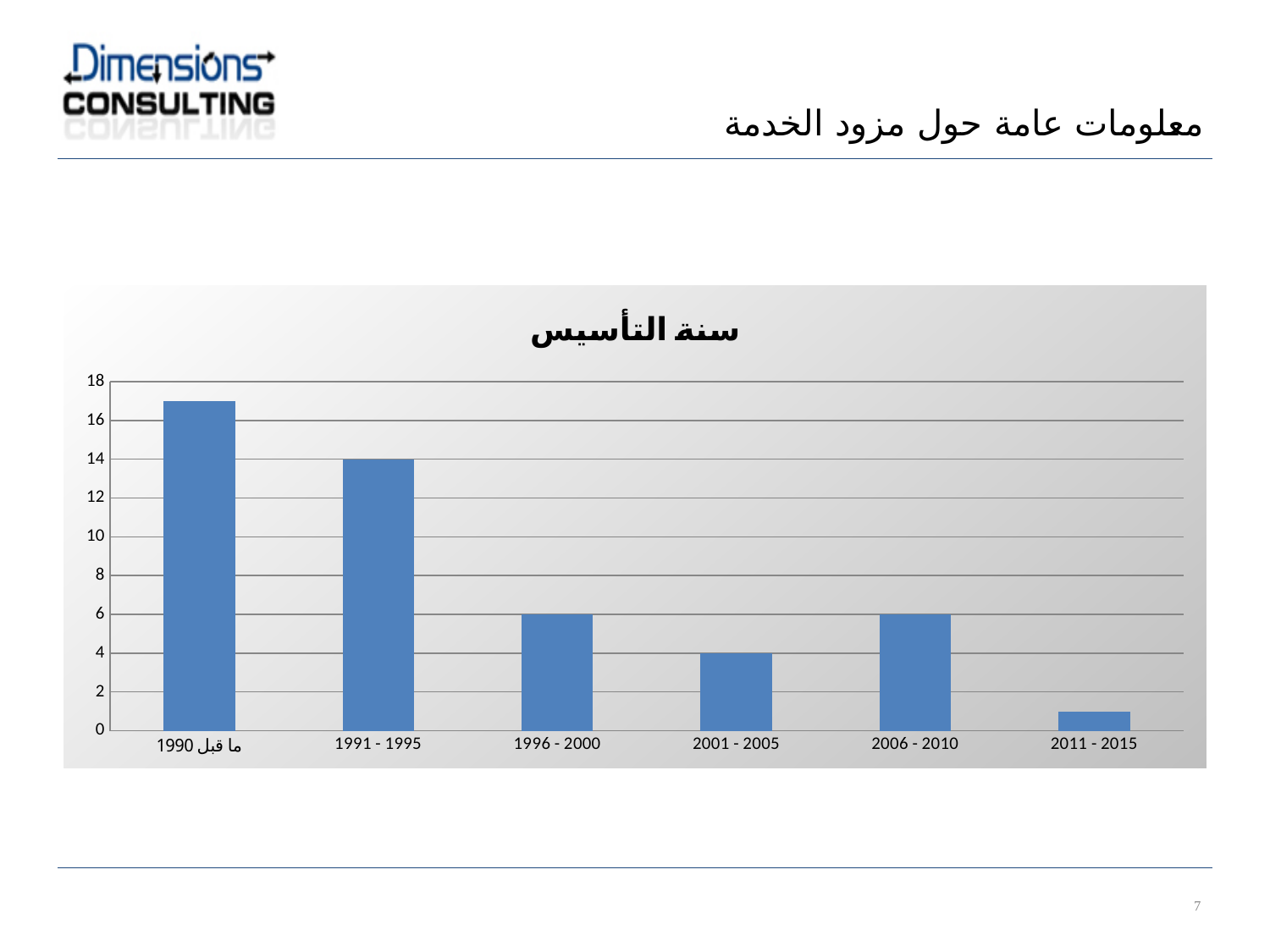
What is the value for 1996 - 2000? 6 Which category has the lowest value? 2011 - 2015 How many categories are shown on the x axis? 6 Which category has the highest value? ما قبل 1990 What is the difference between the values for 1991 - 1995 and 1996 - 2000? 8 Is the value for 2011 - 2015 greater or less than 2? less Which is larger, the value for 2001 - 2005 or the value for 1991 - 1995? 1991 - 1995 What is the value for 1991 - 1995? 14 What is the value for 2006 - 2010? 6 What is the value for 2001 - 2005? 4 What kind of chart is shown on the slide? bar chart Is the value for ما قبل 1990 greater or less than 16? greater